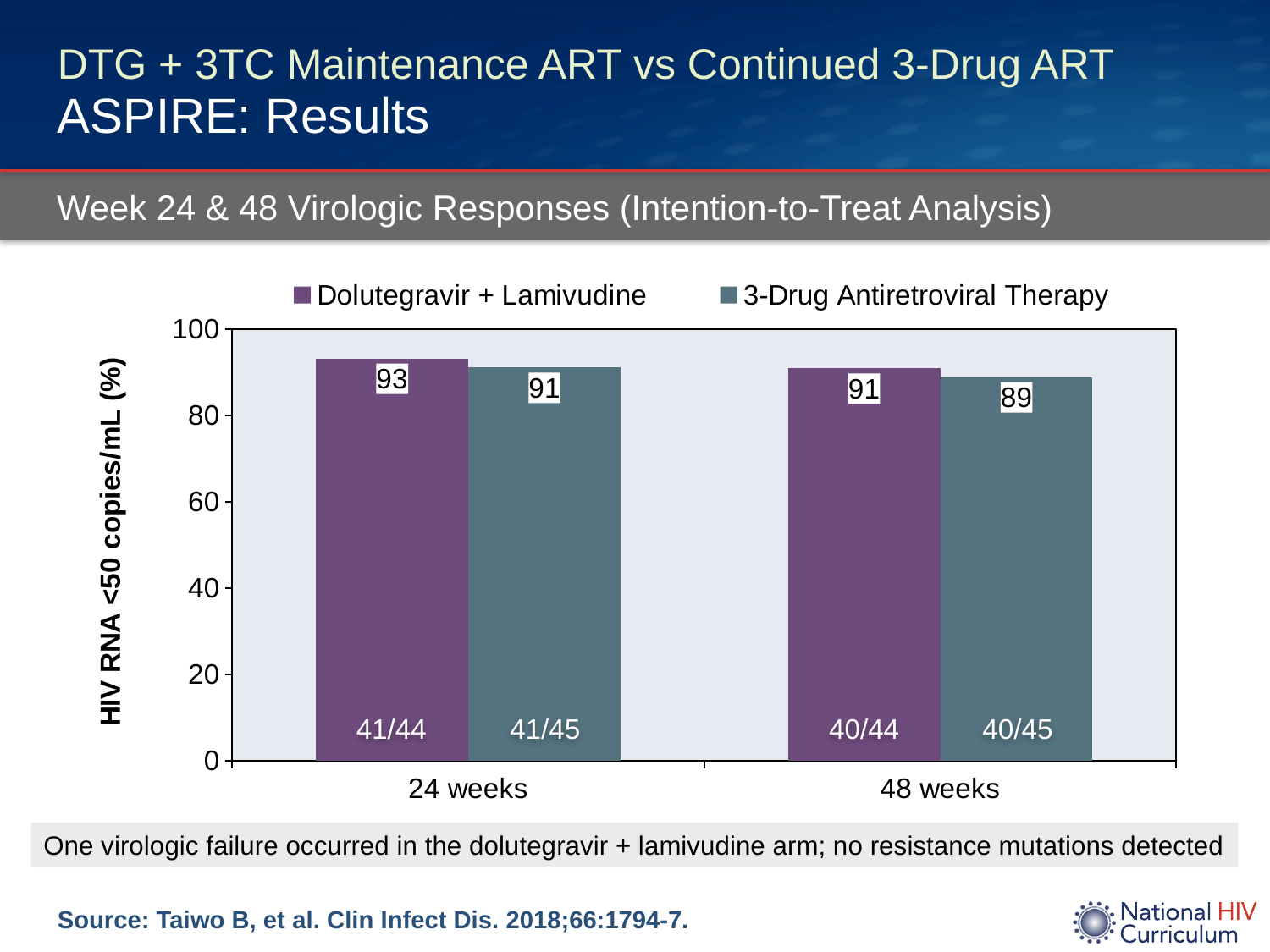
What is the difference between the Dolutegravir + Lamivudine values at 24 weeks and 48 weeks? 2 What is the value for Dolutegravir + Lamivudine at 24 weeks? 93 Which is larger at 48 weeks: Dolutegravir + Lamivudine or 3-Drug Antiretroviral Therapy? Dolutegravir + Lamivudine What is the value for 3-Drug Antiretroviral Therapy at 48 weeks? 89 What is the label of the y axis? HIV RNA <50 copies/mL (%) What kind of chart is shown on the slide? Bar chart How many series does the legend list? 2 What is the value for 3-Drug Antiretroviral Therapy at 24 weeks? 91 What fraction is printed inside the Dolutegravir + Lamivudine bar at 48 weeks? 40/44 Which bar has the highest value on the chart? Dolutegravir + Lamivudine at 24 weeks What is the difference between Dolutegravir + Lamivudine and 3-Drug Antiretroviral Therapy at 24 weeks? 2 Which bar has the lowest value on the chart? 3-Drug Antiretroviral Therapy at 48 weeks